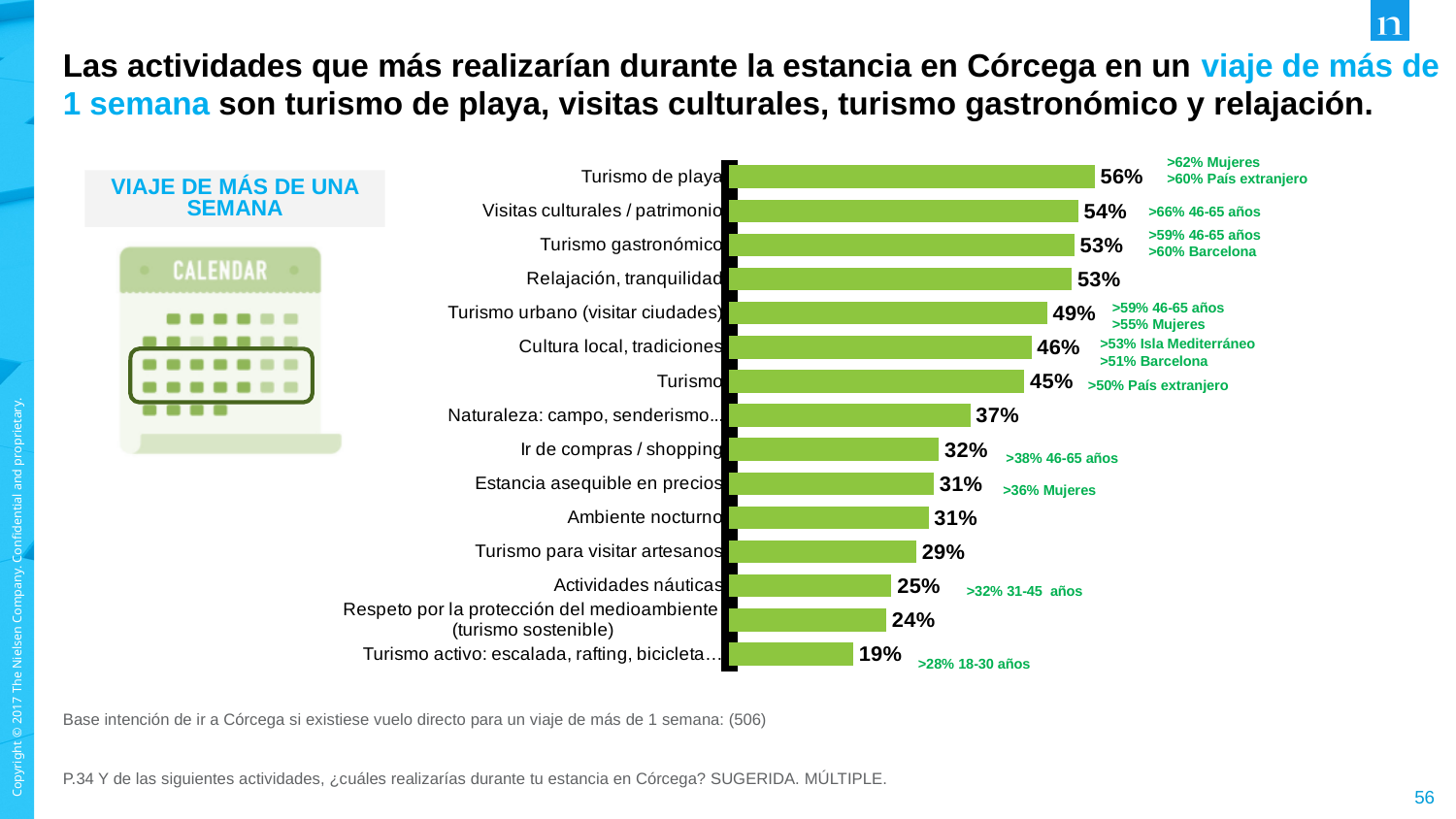
What is the value for Turismo de playa? 56% What kind of chart is shown on the slide? bar chart What is the difference between the values for Visitas culturales / patrimonio and Ir de compras / shopping? 22% How many activities are plotted in the chart? 15 What is the value for Actividades náuticas? 25% What is the value for Naturaleza: campo, senderismo...? 37% What is the difference between the values for Turismo de playa and Turismo activo: escalada, rafting, bicicleta...? 37% What colour are the bars in the chart? green Which is larger, the value for Turismo urbano (visitar ciudades) or the value for Cultura local, tradiciones? Turismo urbano (visitar ciudades) What is the value for Ambiente nocturno? 31% Which activity has the highest value? Turismo de playa Which activity has the lowest value? Turismo activo: escalada, rafting, bicicleta...